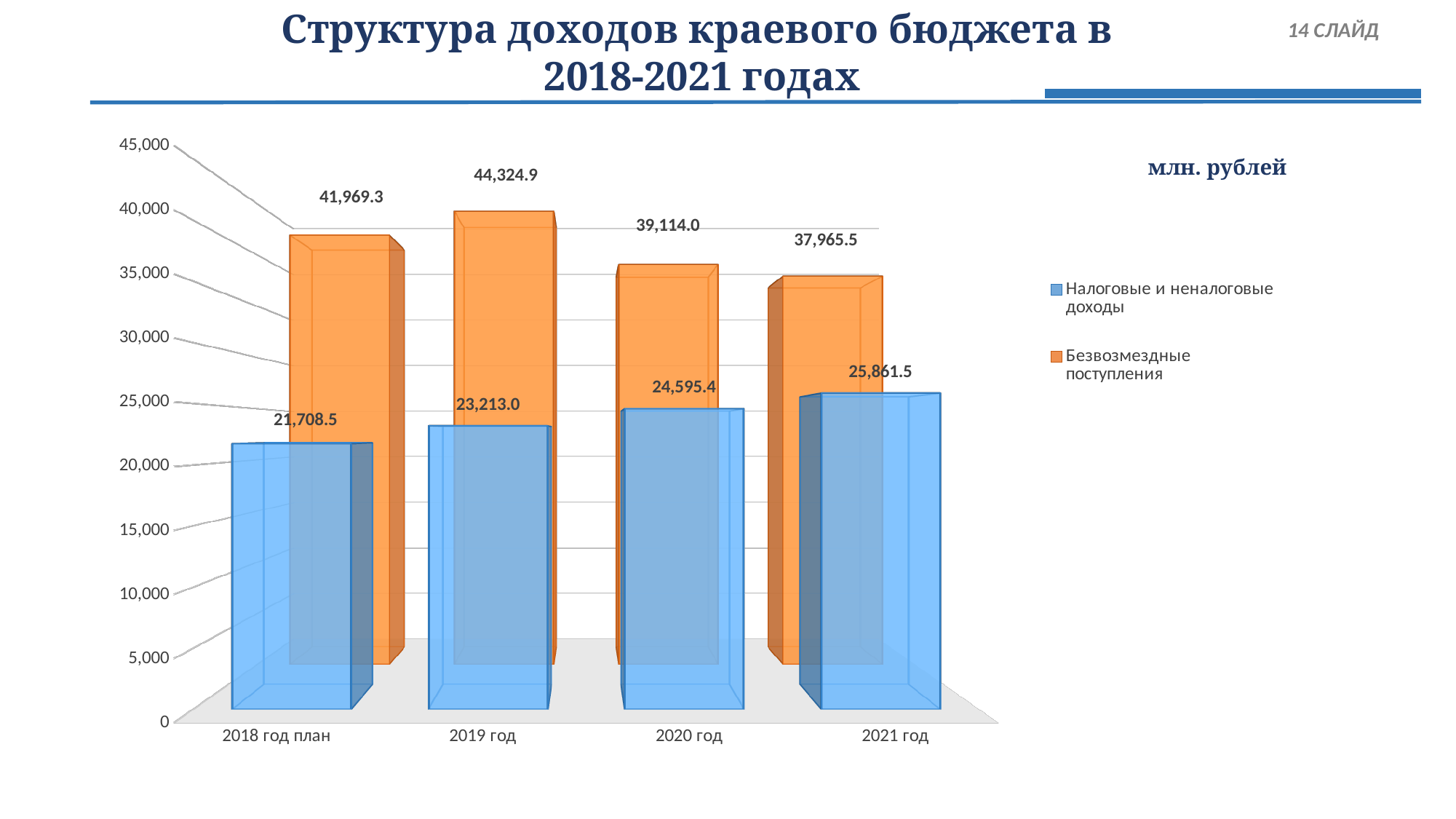
What kind of chart is shown on the slide? Bar chart By how much did Налоговые и неналоговые доходы in 2021 год exceed the 2018 год план value? 4,153.0 In which category is Налоговые и неналоговые доходы lowest? 2018 год план What is the value of Налоговые и неналоговые доходы for 2019 год? 23,213.0 How many categories are shown on the x axis? 4 What is the value of Безвозмездные поступления for 2018 год план? 41,969.3 How many series does the legend list? 2 What is the value of Безвозмездные поступления for 2021 год? 37,965.5 Which is larger in 2020 год: Налоговые и неналоговые доходы or Безвозмездные поступления? Безвозмездные поступления What is the difference between Безвозмездные поступления in 2019 год and 2018 год план? 2,355.6 Do the values of Налоговые и неналоговые доходы rise or fall from 2018 год план to 2021 год? Rise In which year is Безвозмездные поступления highest? 2019 год